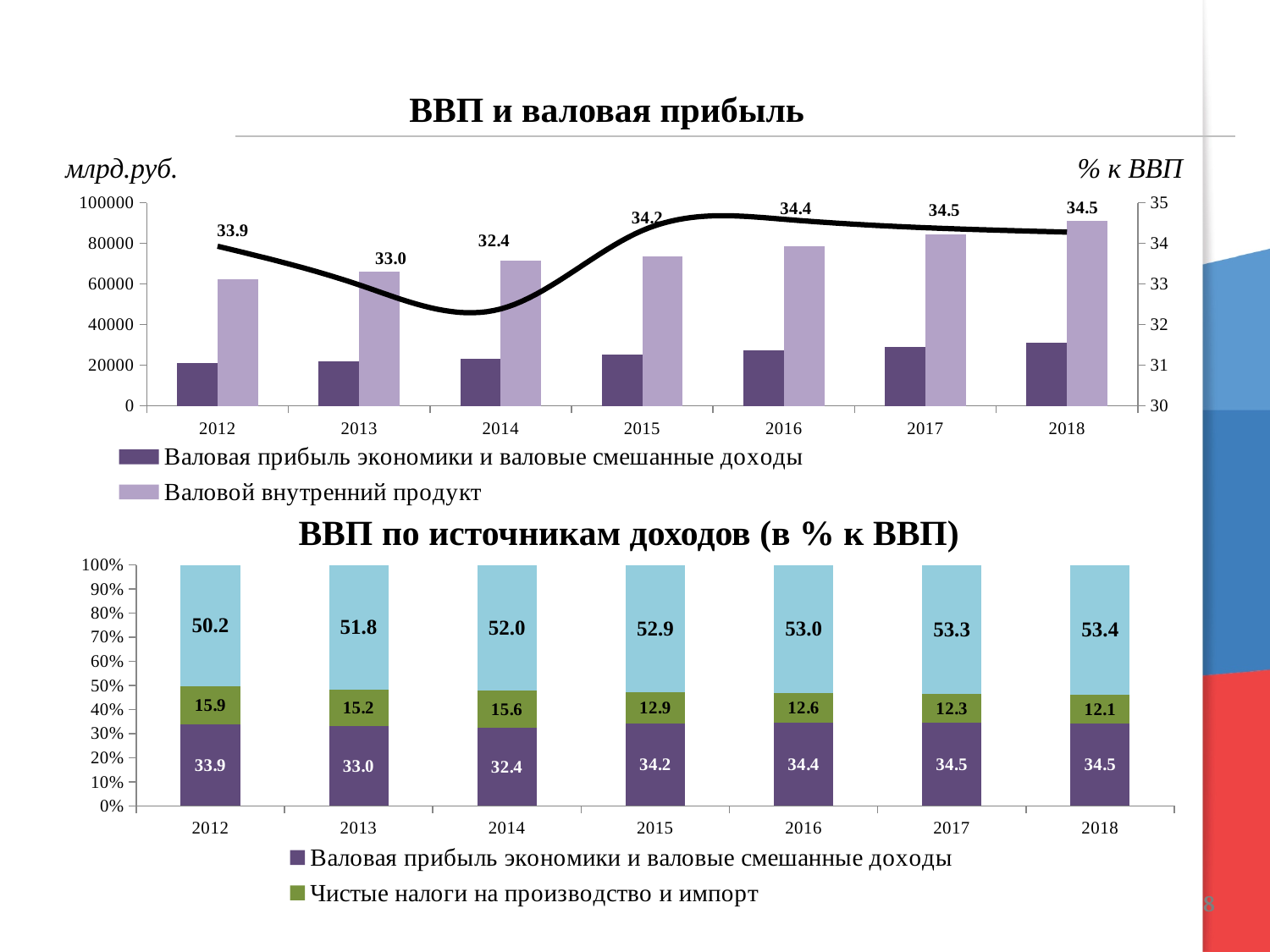
What kind of chart is the bottom chart 'ВВП по источникам доходов (в % к ВВП)'? stacked bar chart In the bottom chart 'ВВП по источникам доходов (в % к ВВП)', which year has the larger 'Валовая прибыль экономики и валовые смешанные доходы' value, 2014 or 2015? 2015 In the bottom chart 'ВВП по источникам доходов (в % к ВВП)', which year has the highest value for the top (light blue) segment? 2018 How many series does the legend of the bottom chart 'ВВП по источникам доходов (в % к ВВП)' list? 2 In the top chart 'ВВП и валовая прибыль', is the 'Валовой внутренний продукт' bar for 2018 greater or less than 80000? greater How many years are shown on the x axis of the top chart 'ВВП и валовая прибыль'? 7 In the top chart 'ВВП и валовая прибыль', what value does the line show for 2014? 32.4 In the bottom chart 'ВВП по источникам доходов (в % к ВВП)', what is the value of the top (light blue) segment for 2016? 53.0 In the bottom chart 'ВВП по источникам доходов (в % к ВВП)', what is the value of 'Чистые налоги на производство и импорт' for 2012? 15.9 In the top chart 'ВВП и валовая прибыль', is the 'Валовая прибыль экономики и валовые смешанные доходы' bar for 2012 greater or less than 40000? less In the top chart 'ВВП и валовая прибыль', in which year is the line value lowest? 2014 In the bottom chart 'ВВП по источникам доходов (в % к ВВП)', what is the difference between the 'Чистые налоги на производство и импорт' values for 2012 and 2018? 3.8